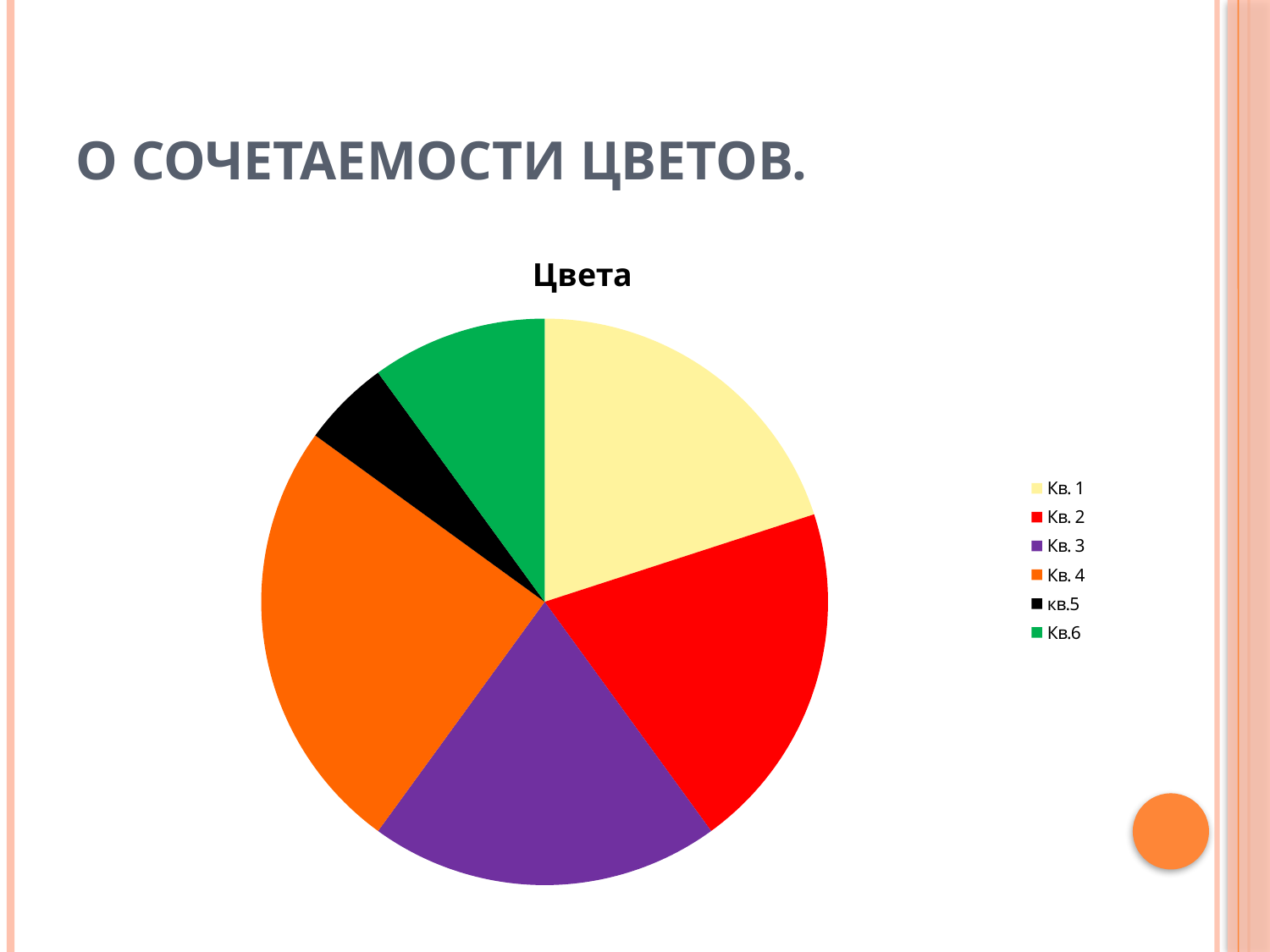
How many entries does the legend of the pie chart list? 6 Which slice is larger, Кв. 4 or кв.5? Кв. 4 Which slice is larger, кв.5 or Кв.6? Кв.6 What is the title of the pie chart? Цвета Which slice is larger, Кв. 4 or Кв.6? Кв. 4 What kind of chart is shown on the slide? pie chart How many slices does the pie chart have? 6 Which category has the smallest slice in the pie chart? кв.5 What colour is the slice for Кв. 3 in the pie chart? purple Which category has the largest slice in the pie chart? Кв. 4